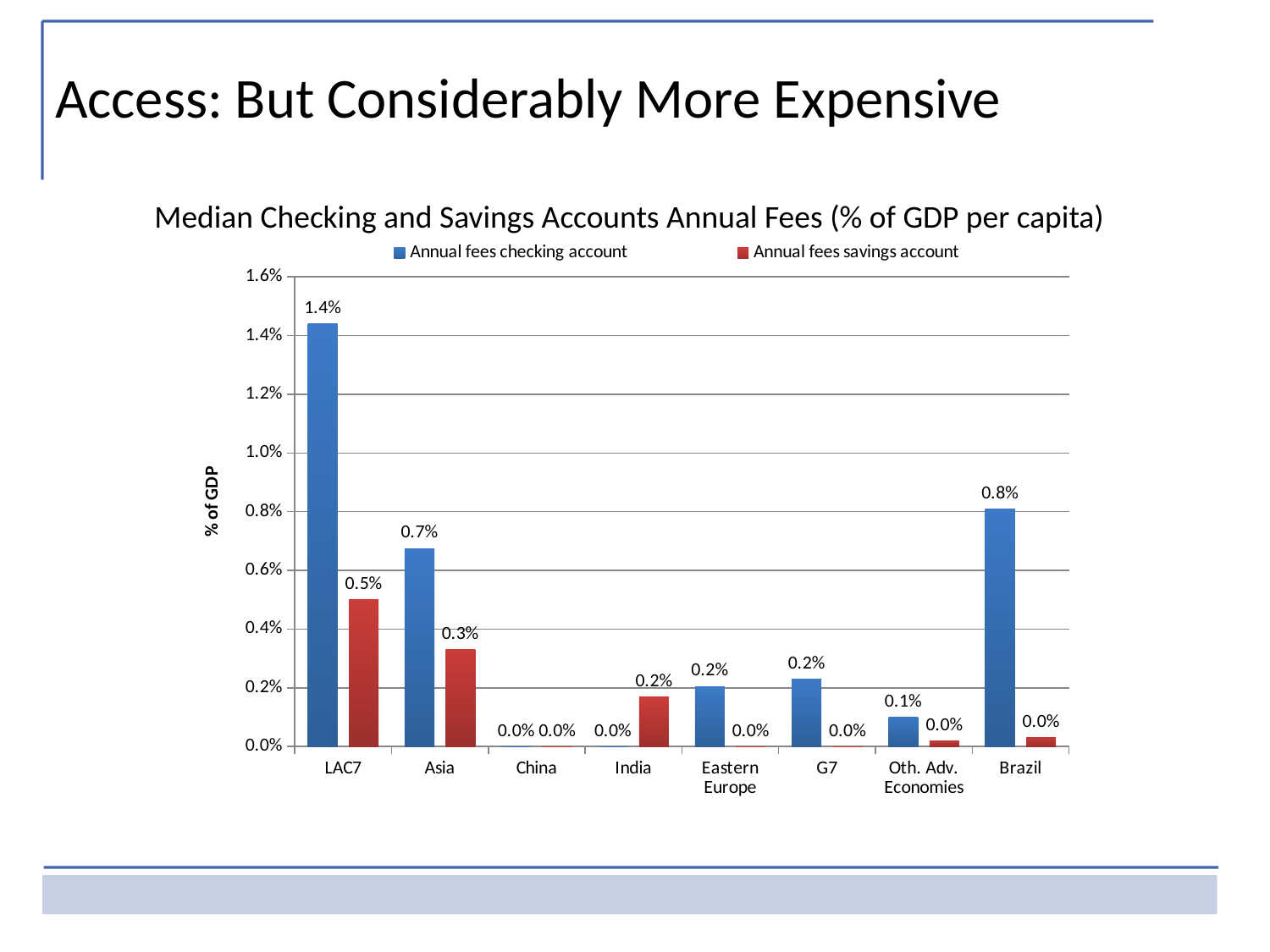
What is the annual fee for a savings account in India? 0.2% Is the checking account fee for LAC7 greater or less than 1.0%? greater Which region has the highest annual fee for a checking account? LAC7 What type of chart is shown on the slide? bar chart What is the difference between the checking account fee and the savings account fee in LAC7? 0.9% How many series does the legend list? 2 What is the annual fee for a savings account in Asia? 0.3% Which region has the highest annual fee for a savings account? LAC7 What is the annual fee for a checking account in LAC7? 1.4% Which is larger: the checking account fee in Brazil or the checking account fee in Asia? Brazil How many regions are shown on the x axis? 8 What is the annual fee for a checking account in Brazil? 0.8%